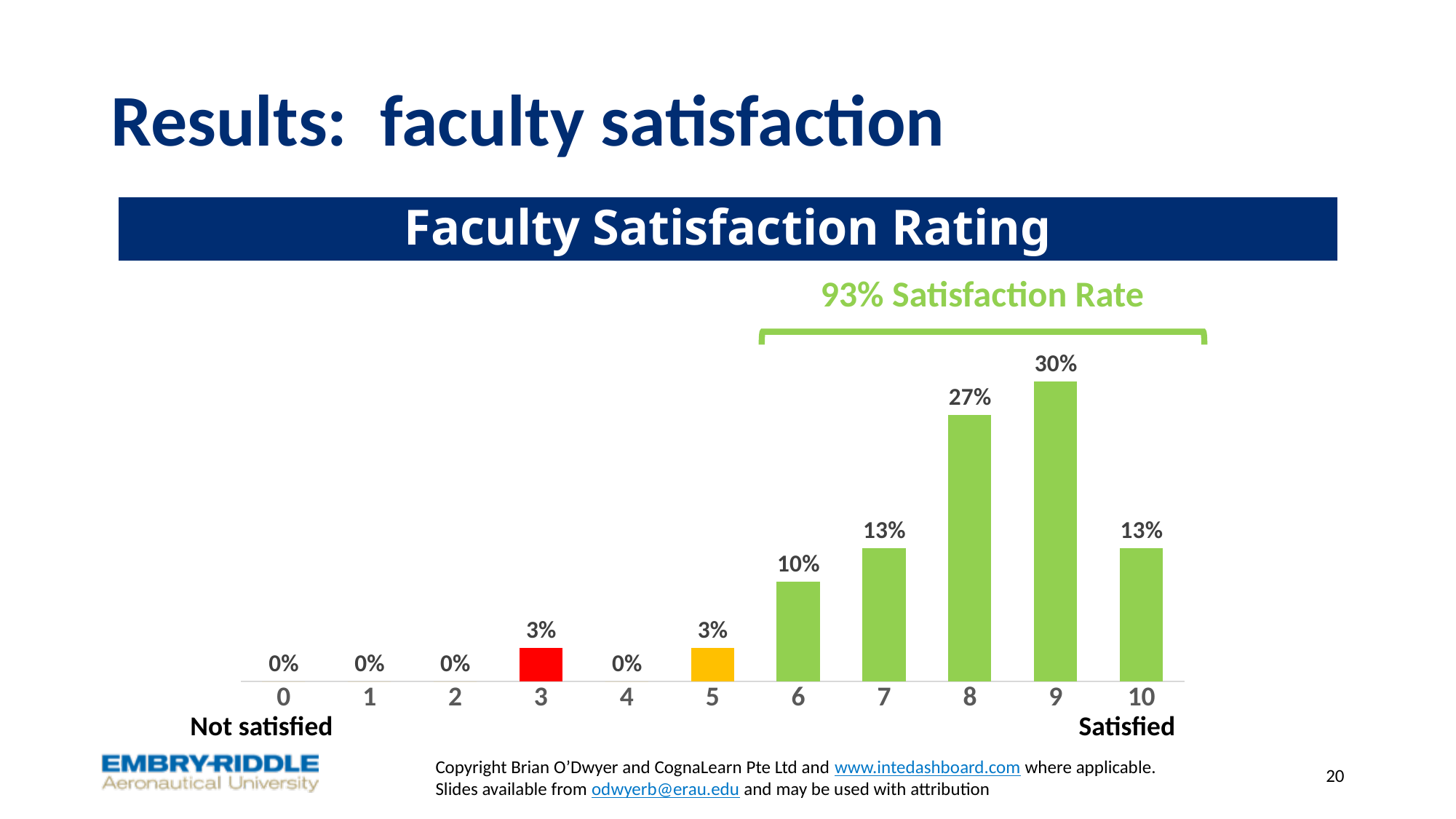
What is the value for rating 9? 30% Which is larger, the value for rating 7 or the value for rating 6? rating 7 What is the title of the chart? Faculty Satisfaction Rating What is the value for rating 6? 10% What is the value for rating 3? 3% What satisfaction rate is shown above the bracket covering ratings 6 to 10? 93% Satisfaction Rate What is the difference between the values for rating 8 and rating 7? 14% How many ratings have a value of 0%? 4 Which rating has the highest value? 9 What kind of chart is shown on the slide? bar chart What is the difference between the values for rating 9 and rating 8? 3% How many rating categories are shown on the x axis? 11